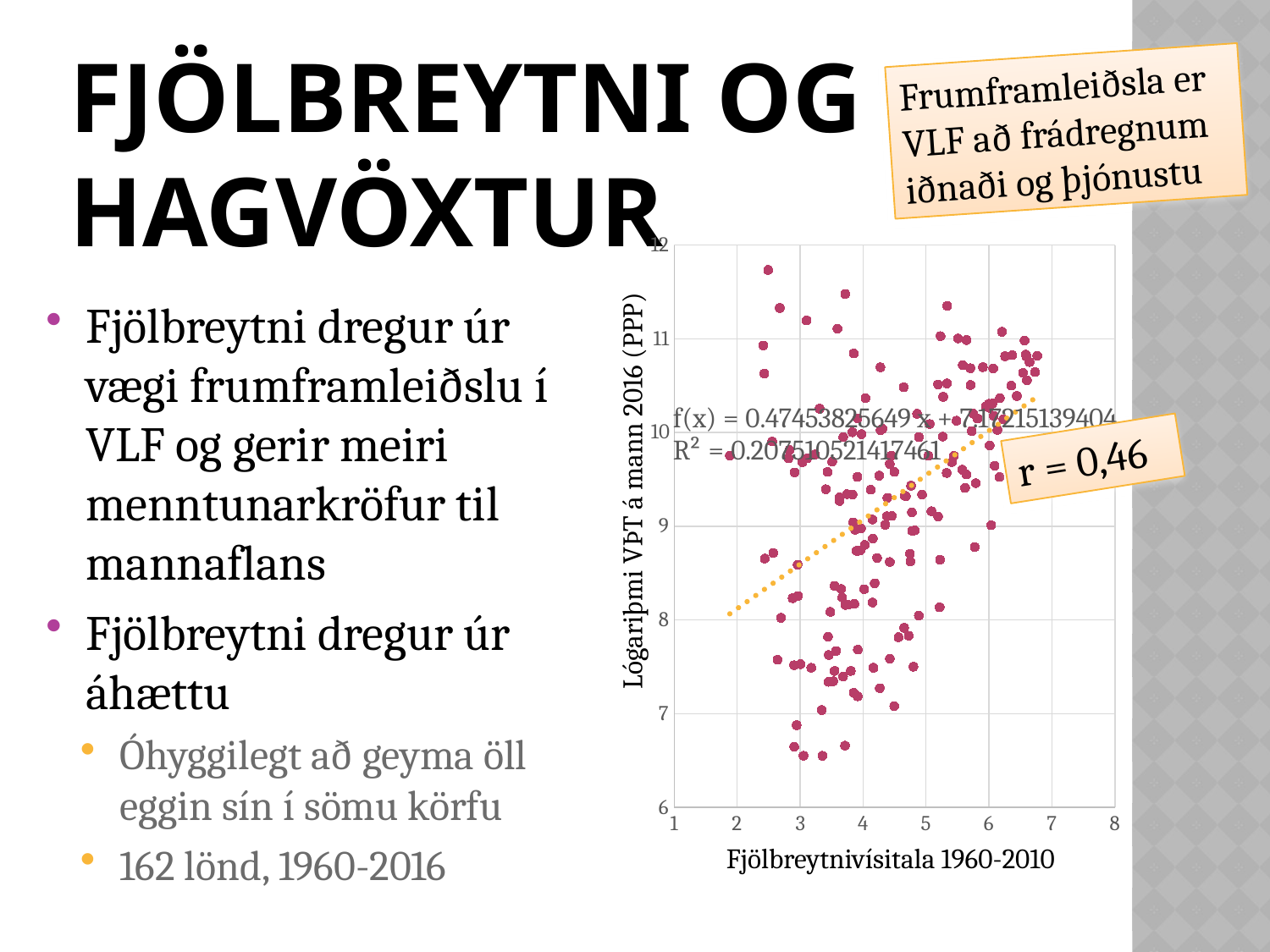
What correlation coefficient r is shown in the callout next to the chart? r = 0,46 What is the highest value shown on the x axis of the chart? 8 What is the title of the y axis of the chart? Lógariþmi VÞT á mann 2016 (PPP) Does the dotted trendline in the scatter chart rise or fall as the Fjölbreytnivísitala increases along the x axis? rise What is the lowest value shown on the y axis of the chart? 6 What kind of chart is shown on the slide? scatter chart What R² value is printed on the chart? 0.207510521417461 What is the slope of the fitted line f(x) shown on the chart? 0.47453825649 What is the intercept of the fitted line f(x) shown on the chart? 7.17215139404 What is the title of the x axis of the chart? Fjölbreytnivísitala 1960-2010